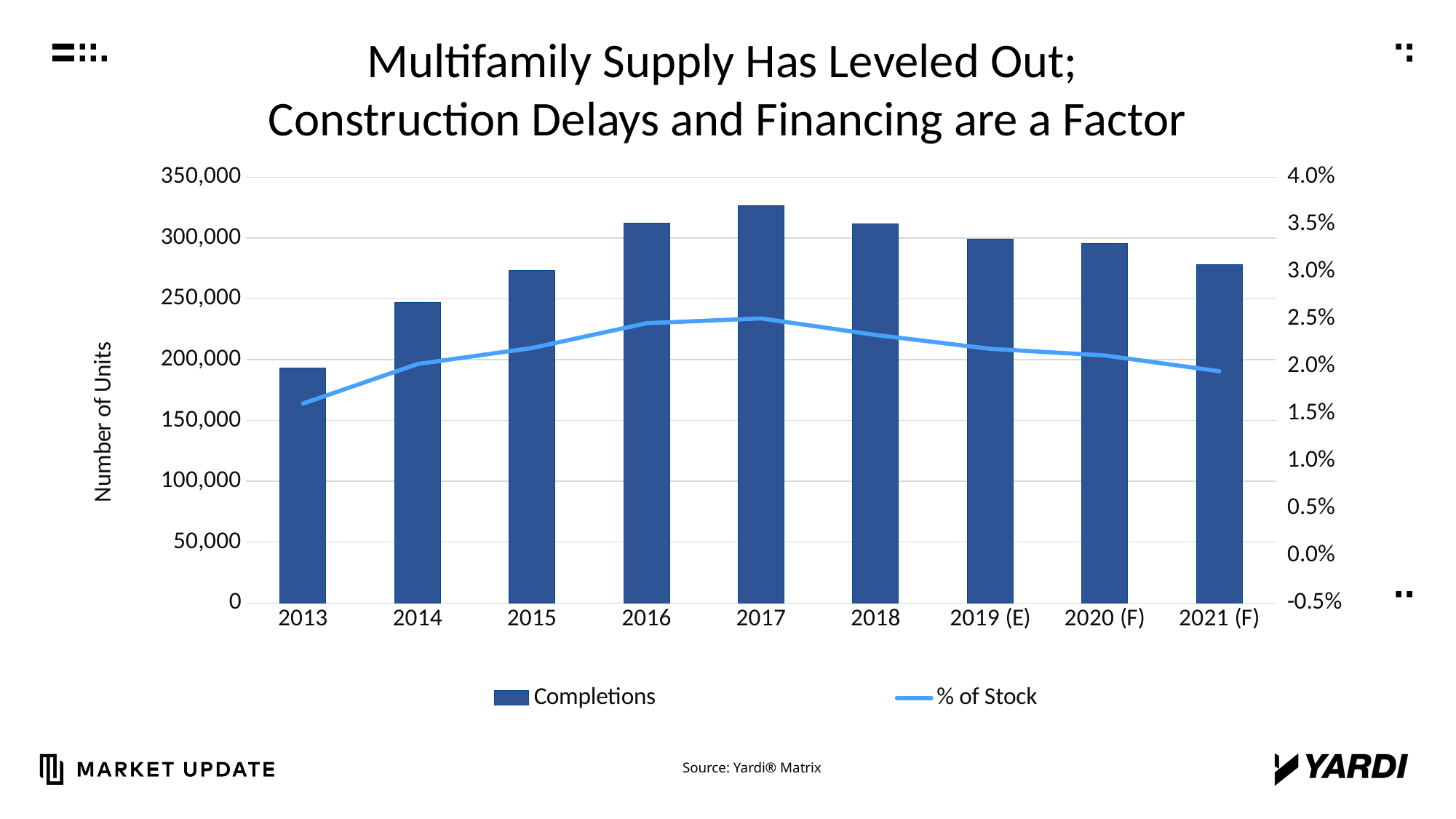
Is the % of Stock value for 2017 greater or less than 2.0%? greater Is the Completions value for 2013 greater or less than 200,000? less Is the % of Stock value for 2013 greater or less than 2.0%? less What is the label on the left vertical axis of the chart? Number of Units Which year has more Completions, 2016 or 2021 (F)? 2016 How many years are shown on the x axis of the chart? 9 Do Completions rise or fall from 2017 to 2021 (F)? fall How many series does the chart's legend list? 2 What kind of chart is shown on the slide? A combination bar and line chart Which year has the lowest number of Completions? 2013 Which year has the highest number of Completions? 2017